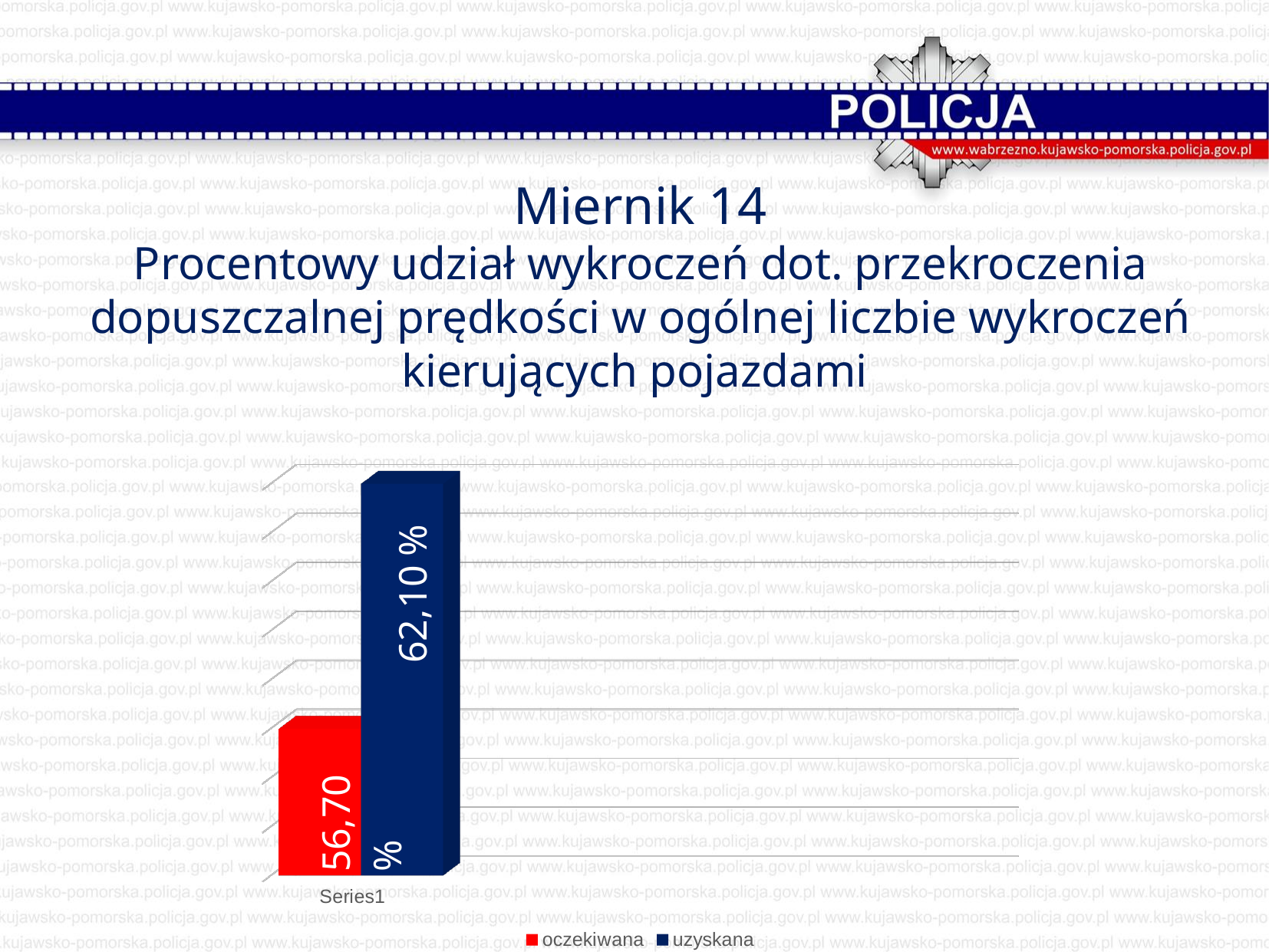
How many series does the legend list? 2 How many bars are plotted on the chart? 2 Which series has the higher value, 'oczekiwana' or 'uzyskana'? uzyskana What is the difference between the 'uzyskana' value and the 'oczekiwana' value? 5,40 % Which series has the highest value on the chart? uzyskana What kind of chart is shown on the slide? bar chart What colour is the 'oczekiwana' bar? red What is the value of the 'uzyskana' bar? 62,10 % Which series has the lowest value on the chart? oczekiwana What is the value of the 'oczekiwana' bar? 56,70 % What is the category label shown on the x axis? Series1